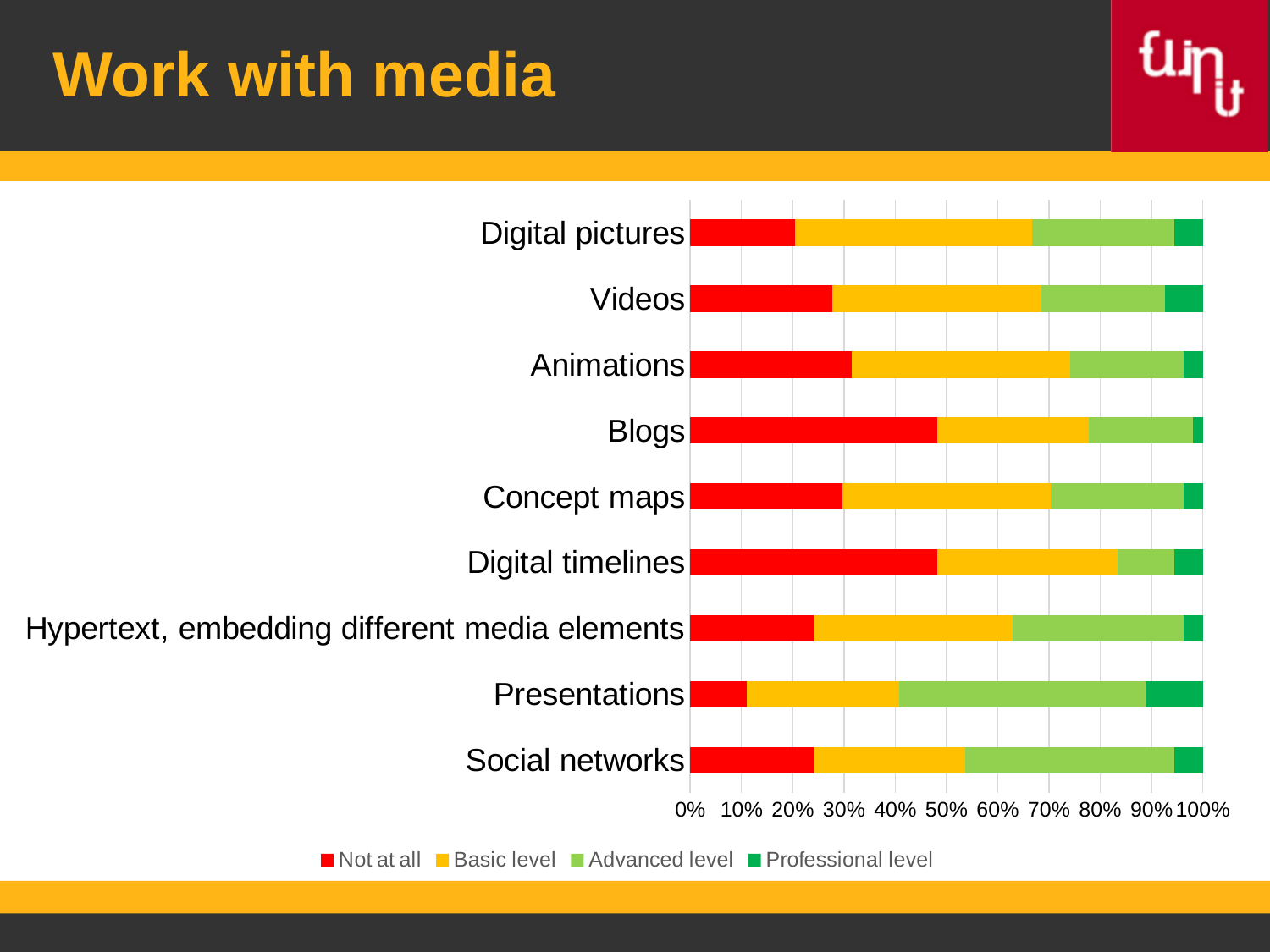
What are the four levels listed in the chart legend? Not at all, Basic level, Advanced level, Professional level What does each stacked bar total on the x axis? 100% How many media categories are listed on the chart? 9 Which category has the largest 'Professional level' share? Presentations Which colour represents the 'Not at all' level in the chart? Red How many series does the legend list? 4 Is the 'Not at all' share for Presentations greater or less than 20%? less Which has a larger 'Not at all' share, Videos or Digital pictures? Videos What kind of chart is shown on the slide? Stacked bar chart Which category has the largest 'Advanced level' share? Presentations Is the 'Not at all' share for Blogs greater or less than 40%? greater Which category has the smallest 'Not at all' share? Presentations